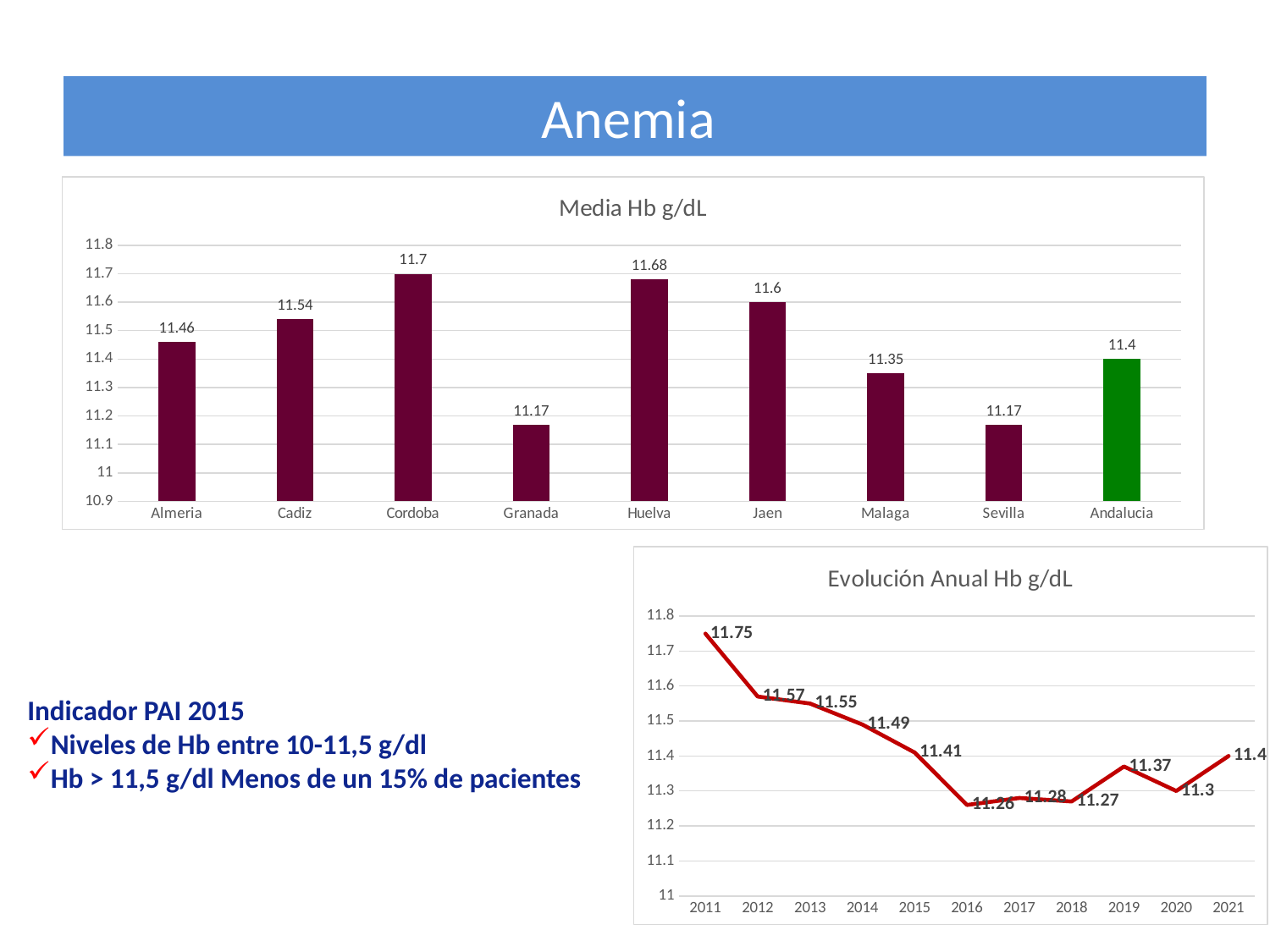
In the 'Media Hb g/dL' chart, which bar is coloured green? Andalucia In the 'Media Hb g/dL' chart, what is the difference between the values for Huelva and Malaga? 0.33 In the 'Evolución Anual Hb g/dL' chart, which year has the lowest value? 2016 In the 'Media Hb g/dL' chart, which is larger, the value for Jaen or the value for Almeria? Jaen In the 'Media Hb g/dL' chart, what is the value for Cadiz? 11.54 In the 'Media Hb g/dL' chart, which category has the highest value? Cordoba In the 'Evolución Anual Hb g/dL' chart, do the values rise or fall from 2011 to 2015? fall In the 'Media Hb g/dL' chart, what is the value for Andalucia? 11.4 How many categories are shown in the 'Media Hb g/dL' chart? 9 How many data points are plotted in the 'Evolución Anual Hb g/dL' chart? 11 What kind of chart is 'Media Hb g/dL'? bar chart In the 'Evolución Anual Hb g/dL' chart, what is the value for 2011? 11.75